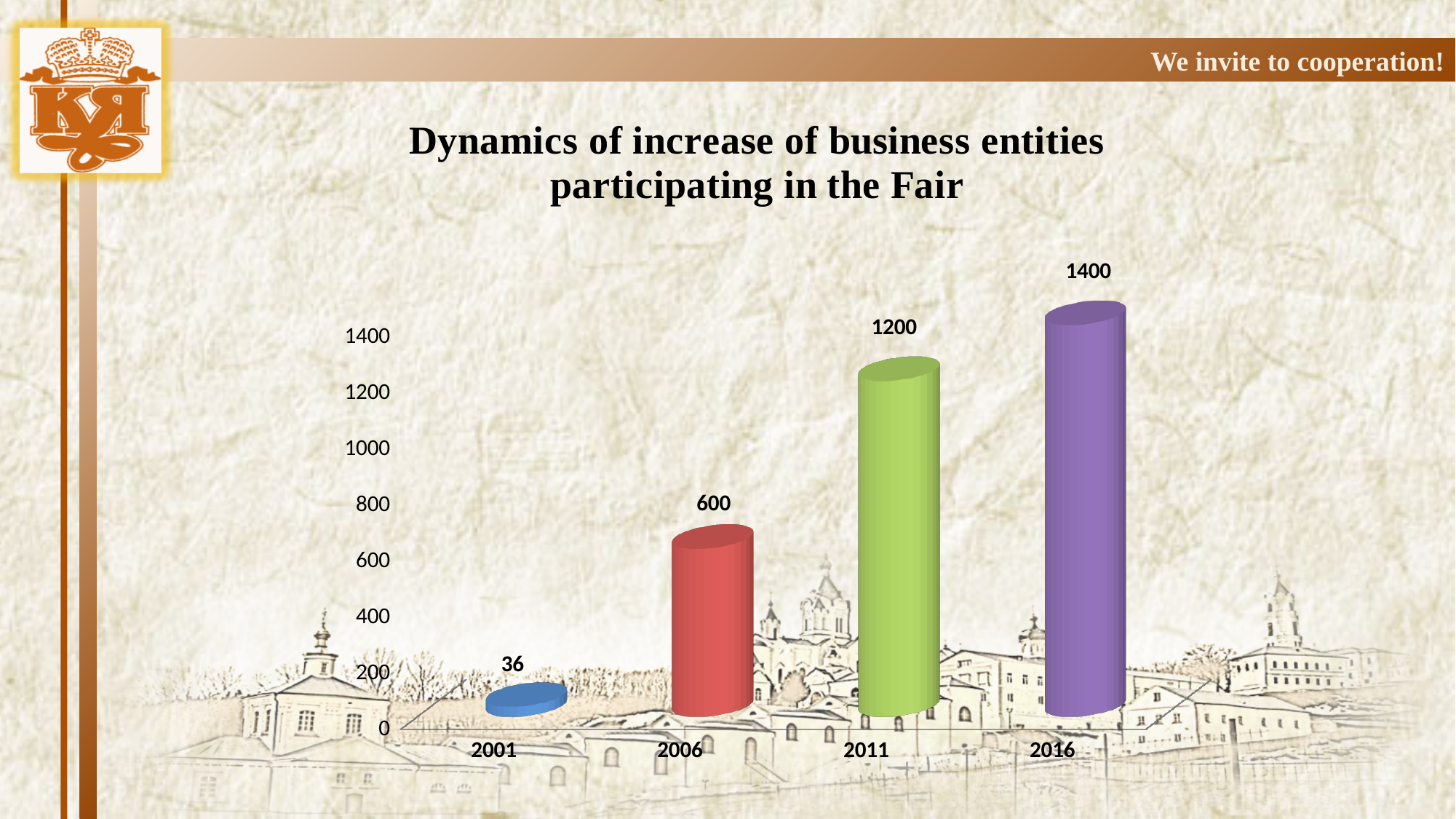
Which is larger, the value for 2006 or the value for 2011? 2011 What is the difference between the values for 2016 and 2011? 200 How many years are shown on the x axis? 4 What is the difference between the values for 2006 and 2001? 564 What is the value for 2001? 36 Do the values rise or fall from 2001 to 2016? rise What is the value for 2016? 1400 What kind of chart is shown on the slide? bar chart Which year has the lowest value? 2001 What is the value for 2011? 1200 Which year has the highest value? 2016 What is the value for 2006? 600